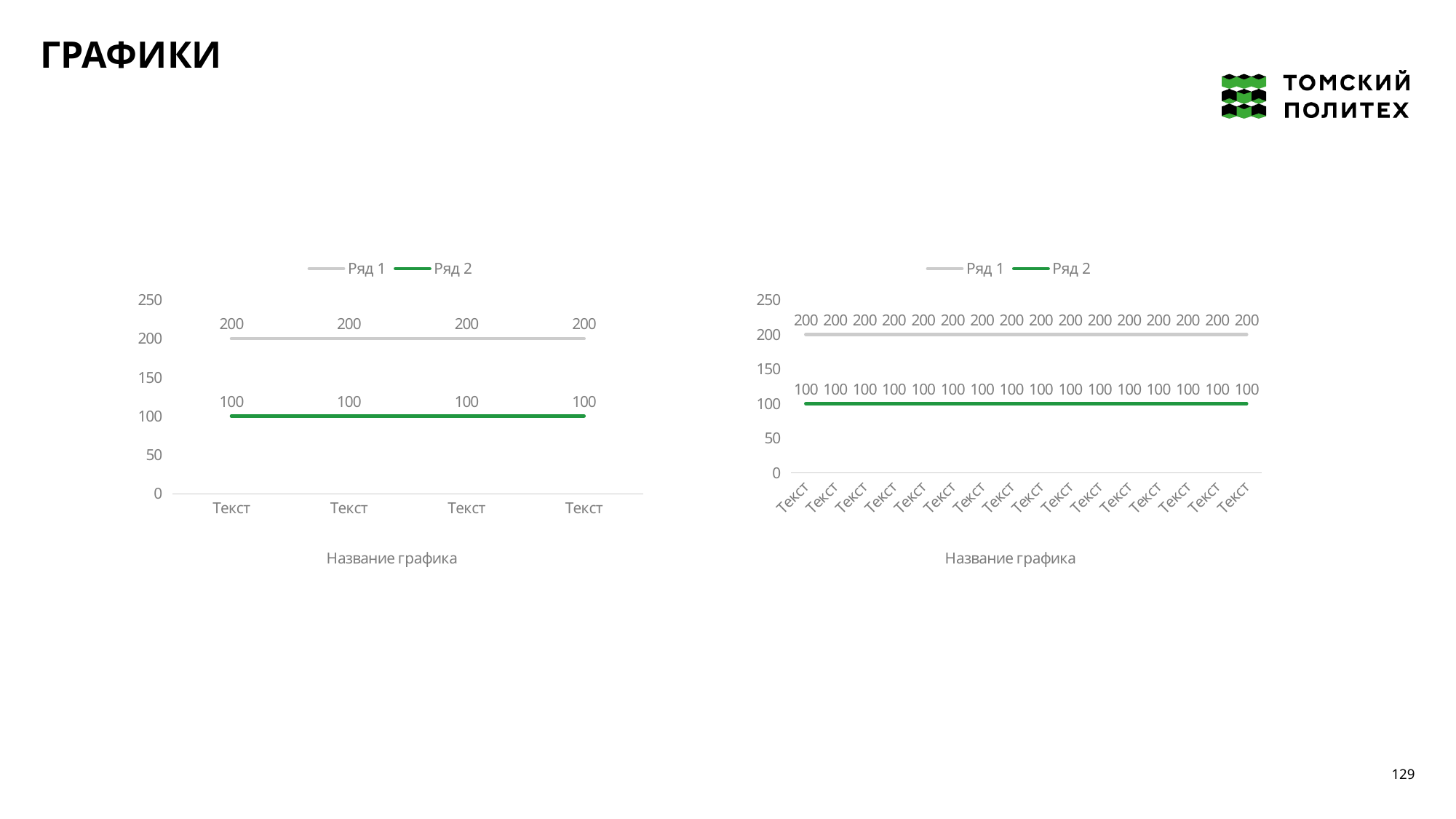
In the left chart, what value does Ряд 2 have at each category? 100 What kind of chart is the left chart on the slide? line chart What kind of chart is the right chart on the slide? line chart In the left chart, how many series does the legend list? 2 In the left chart, what colour is the line for Ряд 2? green In the right chart, do the values of Ряд 1 rise, fall, or stay flat along the x axis? stay flat In the right chart, how many categories are shown on the x axis? 16 In the left chart, what value does Ряд 1 have at each category? 200 In the right chart, which series has the larger values, Ряд 1 or Ряд 2? Ряд 1 In the left chart, how many categories are shown on the x axis? 4 In the right chart, what value does Ряд 2 have at each category? 100 In the left chart, what is the difference between the Ряд 1 value and the Ряд 2 value at any category? 100